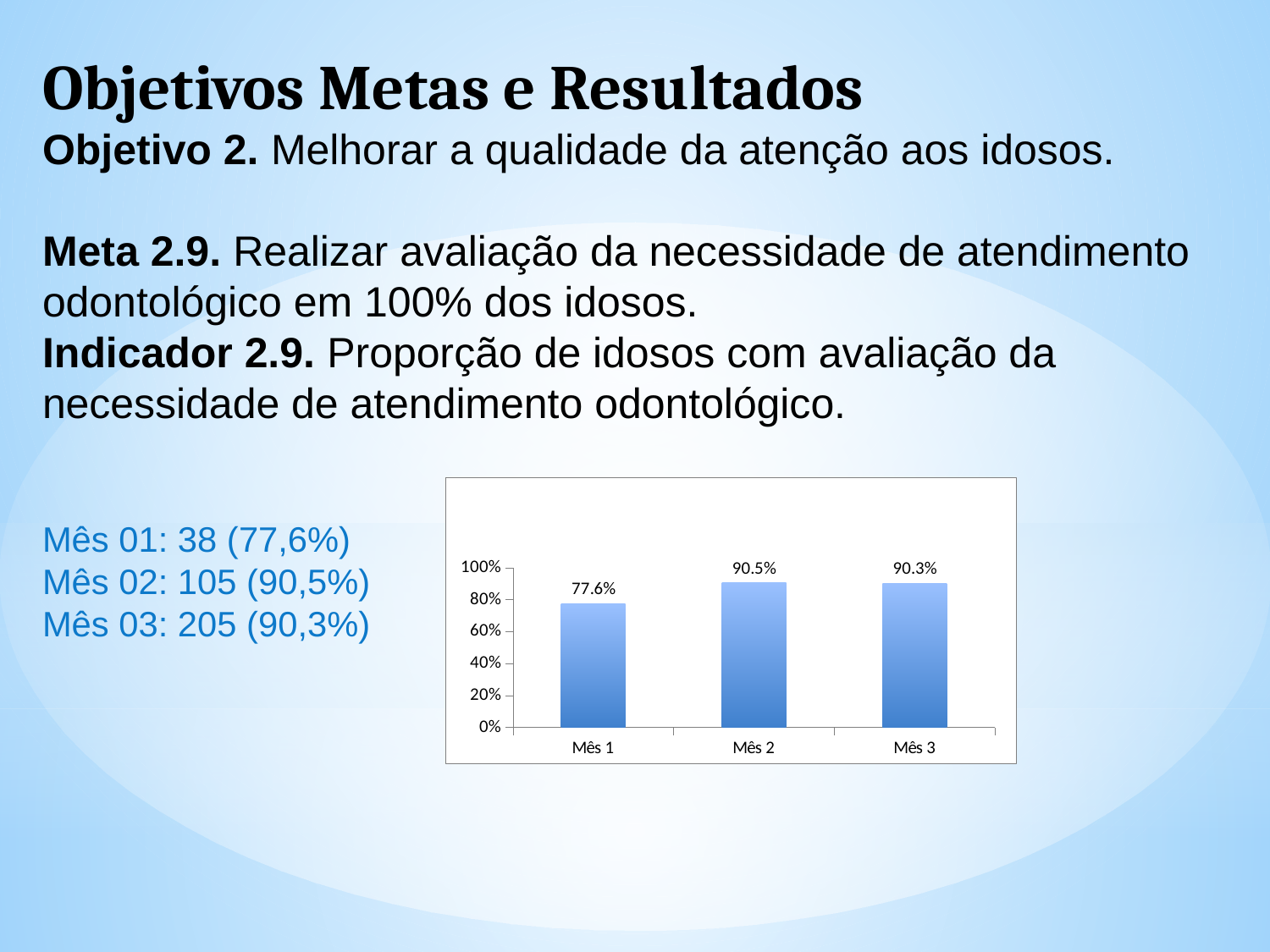
What is the difference between the values for Mês 2 and Mês 3? 0.2 percentage points How many categories are shown on the x axis of the chart? 3 Which is larger, the value for Mês 1 or the value for Mês 3? Mês 3 Which month has the highest value in the chart? Mês 2 What kind of chart is shown on the slide? bar chart What is the value for Mês 2 in the chart? 90.5% What is the highest tick value shown on the y axis of the chart? 100% What is the value for Mês 3 in the chart? 90.3% Which month has the lowest value in the chart? Mês 1 Is the value for Mês 1 greater or less than 80%? less What is the difference between the values for Mês 2 and Mês 1? 12.9 percentage points What is the value for Mês 1 in the chart? 77.6%